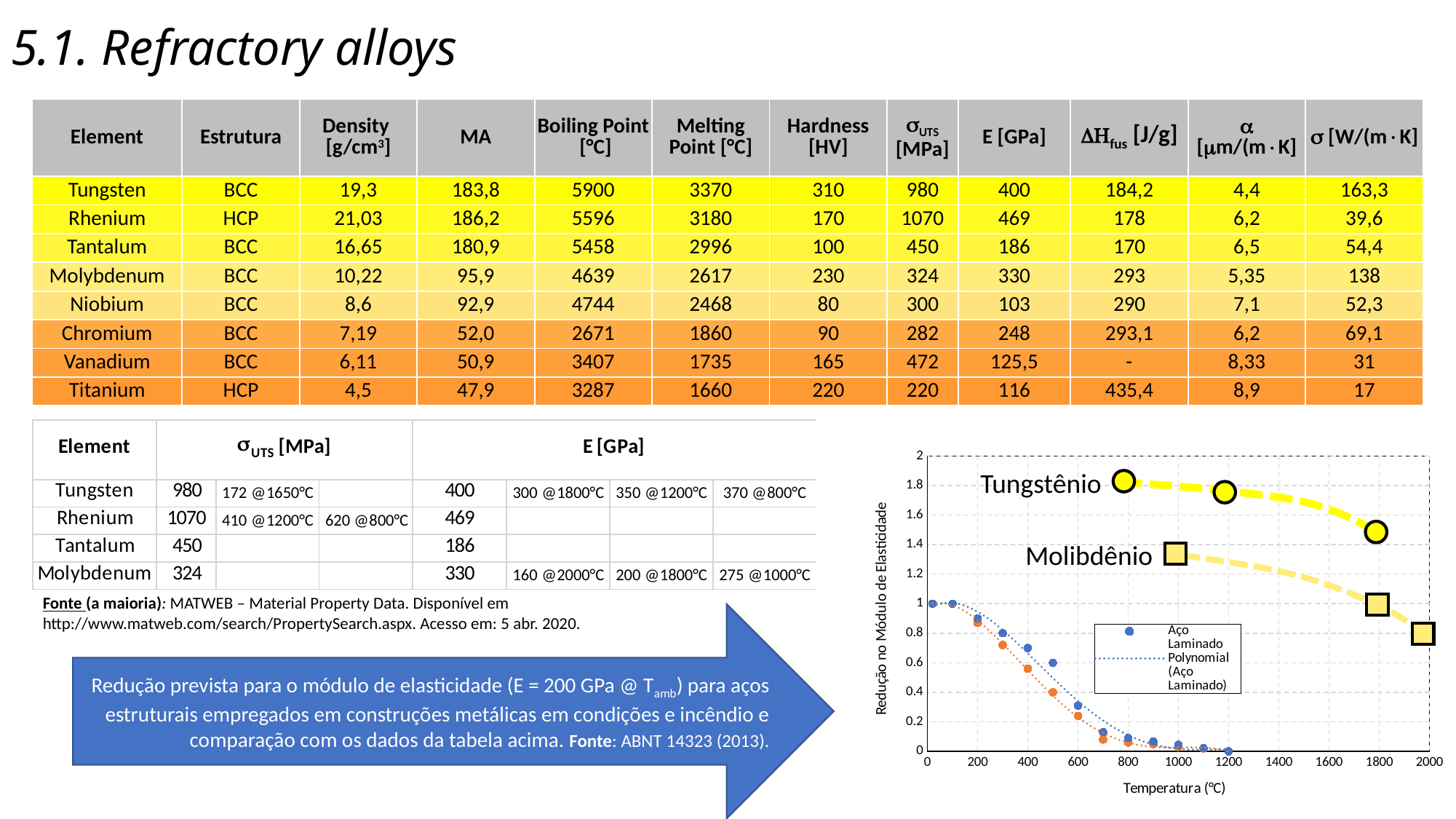
In the chart, is the Aço Laminado value at 200 °C greater or less than 0.8? greater What is the title of the x axis of the chart? Temperatura (°C) What is the title of the y axis of the chart? Redução no Módulo de Elasticidade In the chart, do the Aço Laminado values rise or fall as temperature increases? fall In the chart, is the Aço Laminado value at 1200 °C greater or less than 0.2? less What kind of chart is shown at the bottom right of the slide? scatter chart In the chart, is the Tungstênio marker at about 1800 °C greater or less than 1.2? greater How many series does the legend of the chart list? 2 In the chart, at about 1800 °C, which is higher: the Tungstênio marker or the Molibdênio marker? Tungstênio How many Tungstênio markers are plotted on the chart? 3